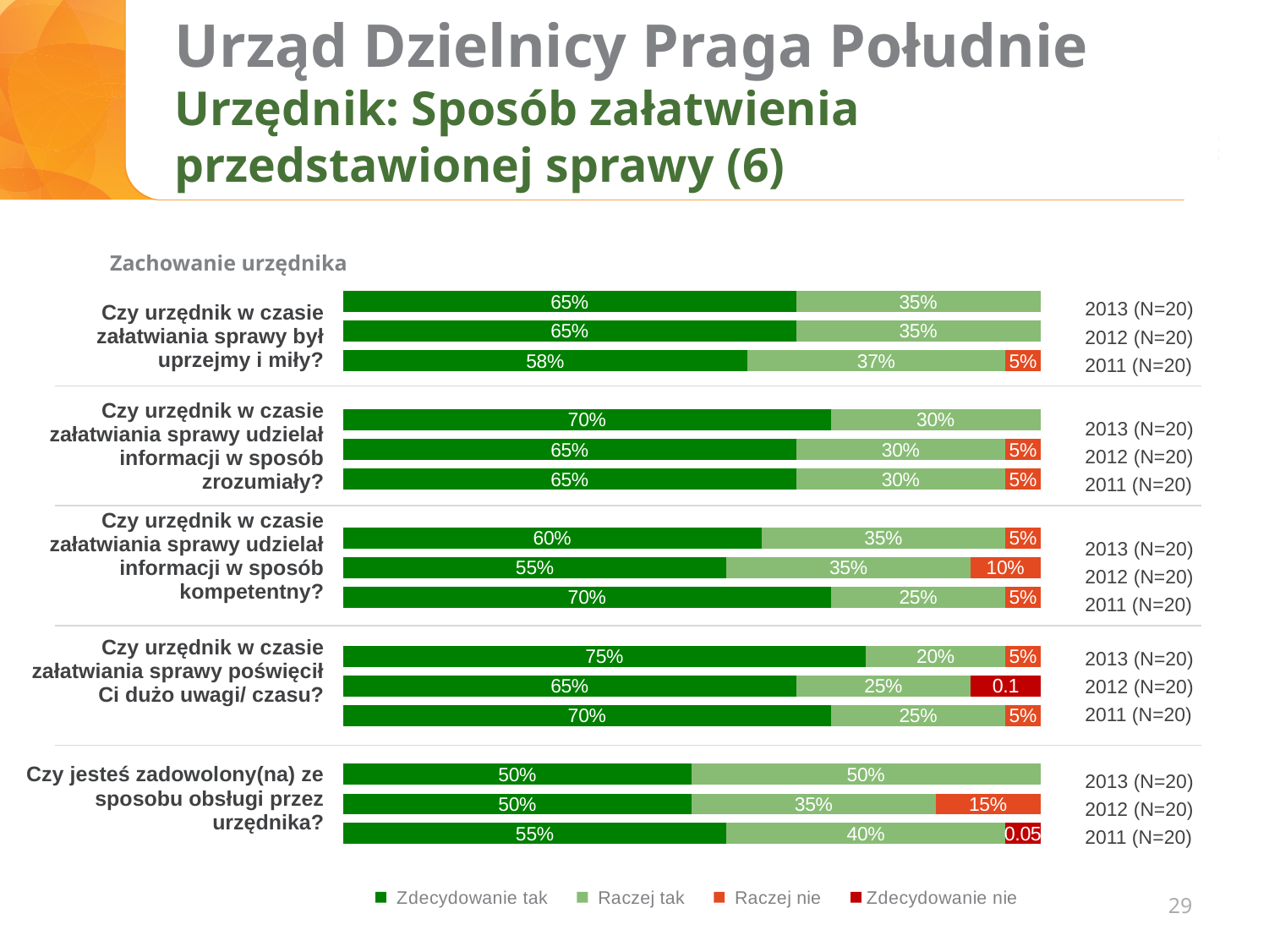
How many series does the legend list? 4 How many years are shown for each question in the chart? 3 What is the sample size (N) shown for each bar in the chart? N=20 What is the "Zdecydowanie tak" value for 2013 for the question "Czy urzędnik w czasie załatwiania sprawy poświęcił Ci dużo uwagi/ czasu?"? 75% Which year has the lowest "Zdecydowanie tak" value for the question "Czy urzędnik w czasie załatwiania sprawy udzielał informacji w sposób kompetentny?"? 2012 What is the difference between the "Zdecydowanie tak" values for 2013 and 2012 for the question "Czy urzędnik w czasie załatwiania sprawy poświęcił Ci dużo uwagi/ czasu?"? 10% What is the "Raczej nie" value for 2012 for the question "Czy jesteś zadowolony(na) ze sposobu obsługi przez urzędnika?"? 15% Which year has the highest "Zdecydowanie tak" value for the question "Czy urzędnik w czasie załatwiania sprawy udzielał informacji w sposób zrozumiały?"? 2013 For the question "Czy jesteś zadowolony(na) ze sposobu obsługi przez urzędnika?", is the "Raczej tak" value larger in 2013 or in 2012? 2013 What is the "Zdecydowanie tak" value for 2012 for the question "Czy urzędnik w czasie załatwiania sprawy udzielał informacji w sposób kompetentny?"? 55% What kind of chart is shown on the slide? Stacked bar chart What is the "Raczej tak" value for 2011 for the question "Czy urzędnik w czasie załatwiania sprawy był uprzejmy i miły?"? 37%